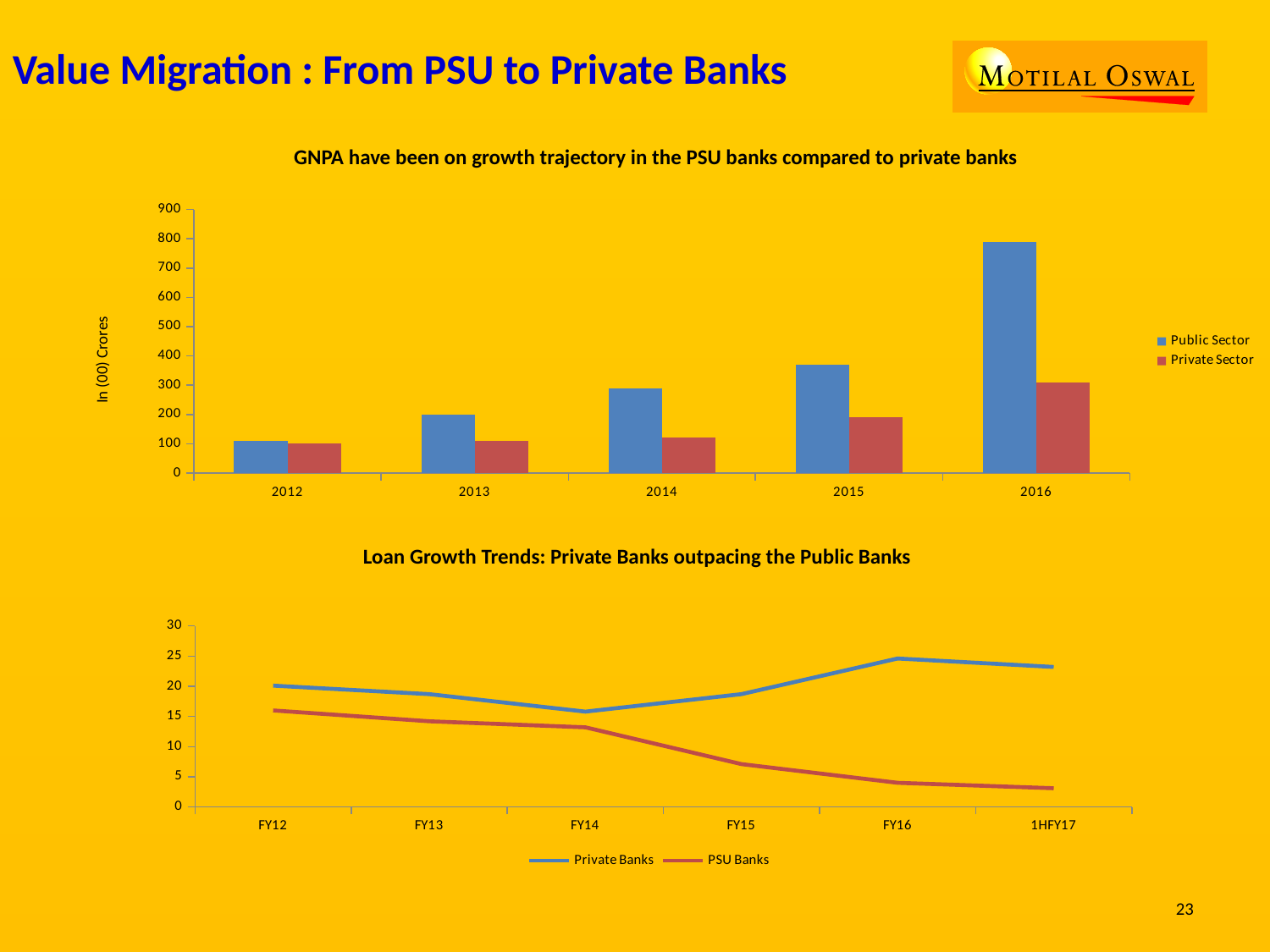
In the bottom Loan Growth Trends chart, how many points are shown on the x axis? 6 In the top GNPA chart, which is larger in 2015, the Public Sector value or the Private Sector value? Public Sector In the top GNPA chart, do the Public Sector values rise or fall from 2012 to 2016? rise In the top GNPA chart, how many years are shown on the x axis? 5 In the top GNPA chart, is the Private Sector value for 2014 greater or less than 200? less In the top GNPA chart, is the Public Sector value for 2016 greater or less than 700? greater In the bottom Loan Growth Trends chart, do the PSU Banks values rise or fall from FY12 to 1HFY17? fall In the bottom chart titled 'Loan Growth Trends: Private Banks outpacing the Public Banks', what kind of chart is shown? line chart In the bottom Loan Growth Trends chart, is the Private Banks value for FY16 greater or less than 20? greater In the top GNPA chart, how many series does the legend list? 2 In the top chart titled 'GNPA have been on growth trajectory in the PSU banks compared to private banks', what kind of chart is shown? bar chart In the top GNPA chart, which year has the highest Public Sector value? 2016